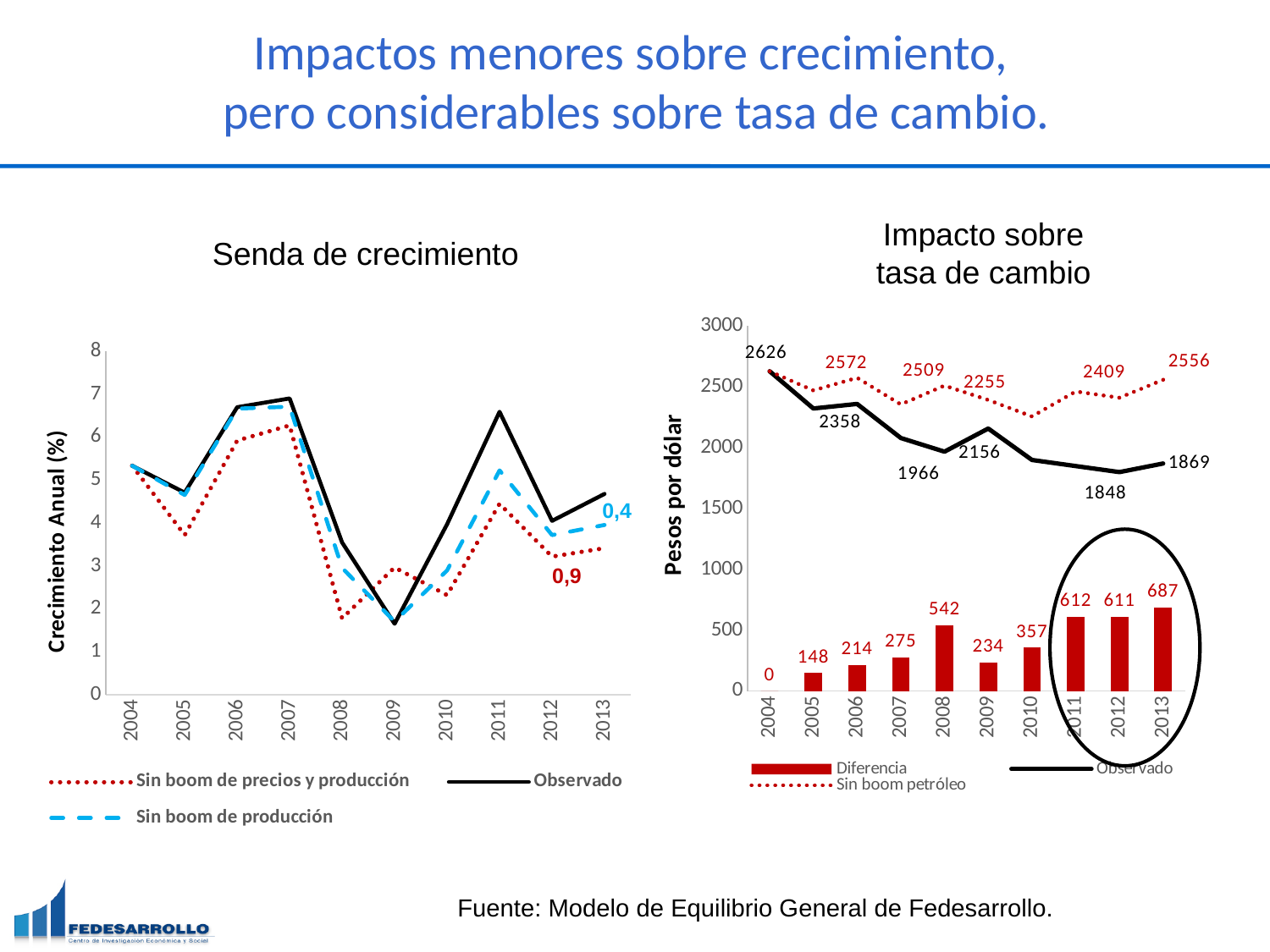
In the 'Impacto sobre tasa de cambio' chart, does the Observado line generally rise or fall from 2004 to 2013? fall In the 'Impacto sobre tasa de cambio' chart, what is the Observado value for 2013? 1869 In the 'Impacto sobre tasa de cambio' chart, how many series does the legend list? 3 In the 'Impacto sobre tasa de cambio' chart, which year has the highest Diferencia bar? 2013 In the 'Senda de crecimiento' chart, is the Observado value for 2009 greater or less than 2? less In the 'Impacto sobre tasa de cambio' chart, what is the Observado value for 2004? 2626 In the 'Senda de crecimiento' chart, is the Observado value for 2007 greater or less than 6? greater In the 'Impacto sobre tasa de cambio' chart, which is larger, the Diferencia bar for 2008 or for 2010? 2008 In the 'Impacto sobre tasa de cambio' chart, what is the value of the Diferencia bar for 2008? 542 In the 'Impacto sobre tasa de cambio' chart, which year has the lowest Diferencia bar? 2004 In the 'Impacto sobre tasa de cambio' chart, what is the difference between the Diferencia bars for 2013 and 2011? 75 What kind of chart is 'Senda de crecimiento'? line chart